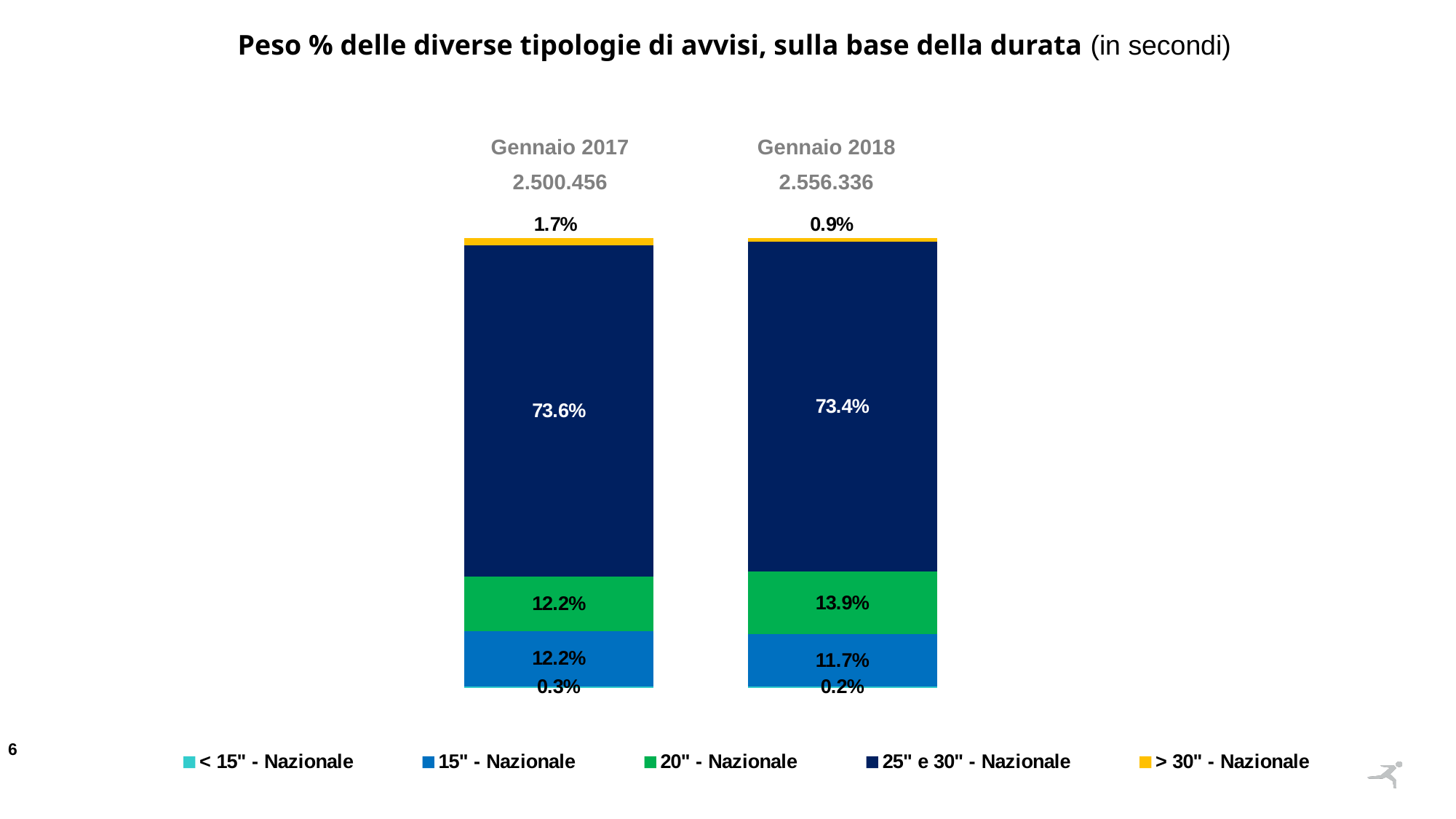
What kind of chart is shown on the slide? Stacked bar chart Which series has the smallest share in the Gennaio 2017 bar? < 15" - Nazionale What is the value for the > 30" - Nazionale series in Gennaio 2017? 1.7% What total figure is printed above the Gennaio 2018 bar? 2.556.336 What is the value for the 20" - Nazionale series in the Gennaio 2018 bar? 13.9% What is the value for the < 15" - Nazionale series in Gennaio 2018? 0.2% Which series has the largest share in the Gennaio 2018 bar? 25" e 30" - Nazionale Is the 15" - Nazionale share larger in Gennaio 2017 or Gennaio 2018? Gennaio 2017 By how many percentage points did the 20" - Nazionale share increase from Gennaio 2017 to Gennaio 2018? 1.7 percentage points What is the value for the 25" e 30" - Nazionale series in the Gennaio 2017 bar? 73.6% How many stacked bars are shown in the chart? 2 How many series does the legend list? 5